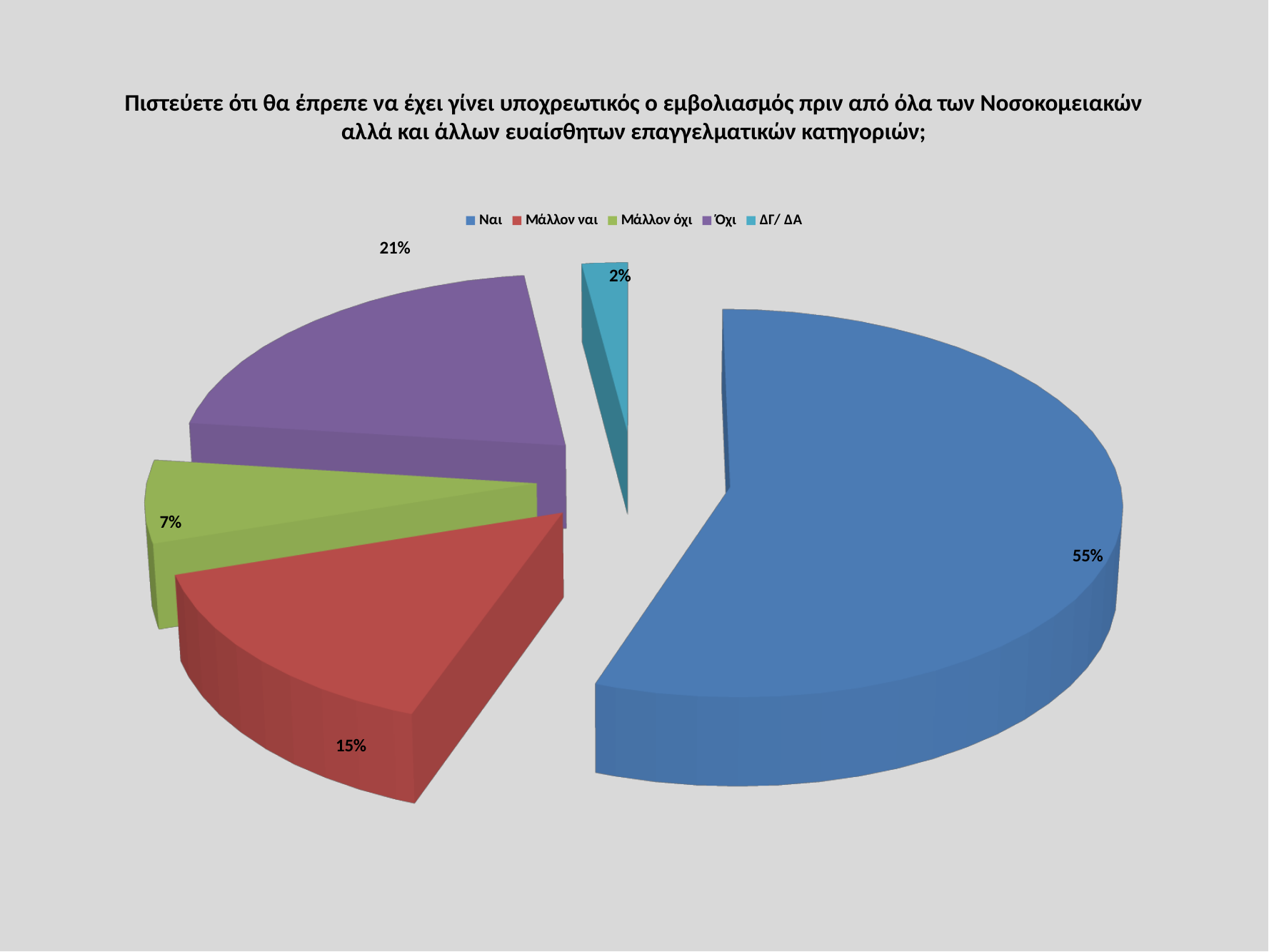
Which slice is larger, 'Μάλλον ναι' or 'Μάλλον όχι'? Μάλλον ναι What percentage is shown for the 'Ναι' slice? 55% What colour is the 'Όχι' slice? Purple What percentage is shown for the 'Μάλλον όχι' slice? 7% What percentage is shown for the 'Μάλλον ναι' slice? 15% Which category has the smallest slice of the pie? ΔΓ/ ΔΑ What percentage is shown for the 'Όχι' slice? 21% Which category has the largest slice of the pie? Ναι What kind of chart is shown on the slide? Pie chart What is the difference in percentage points between the 'Ναι' slice and the 'Όχι' slice? 34 What percentage is shown for the 'ΔΓ/ ΔΑ' slice? 2% How many categories does the legend list? 5